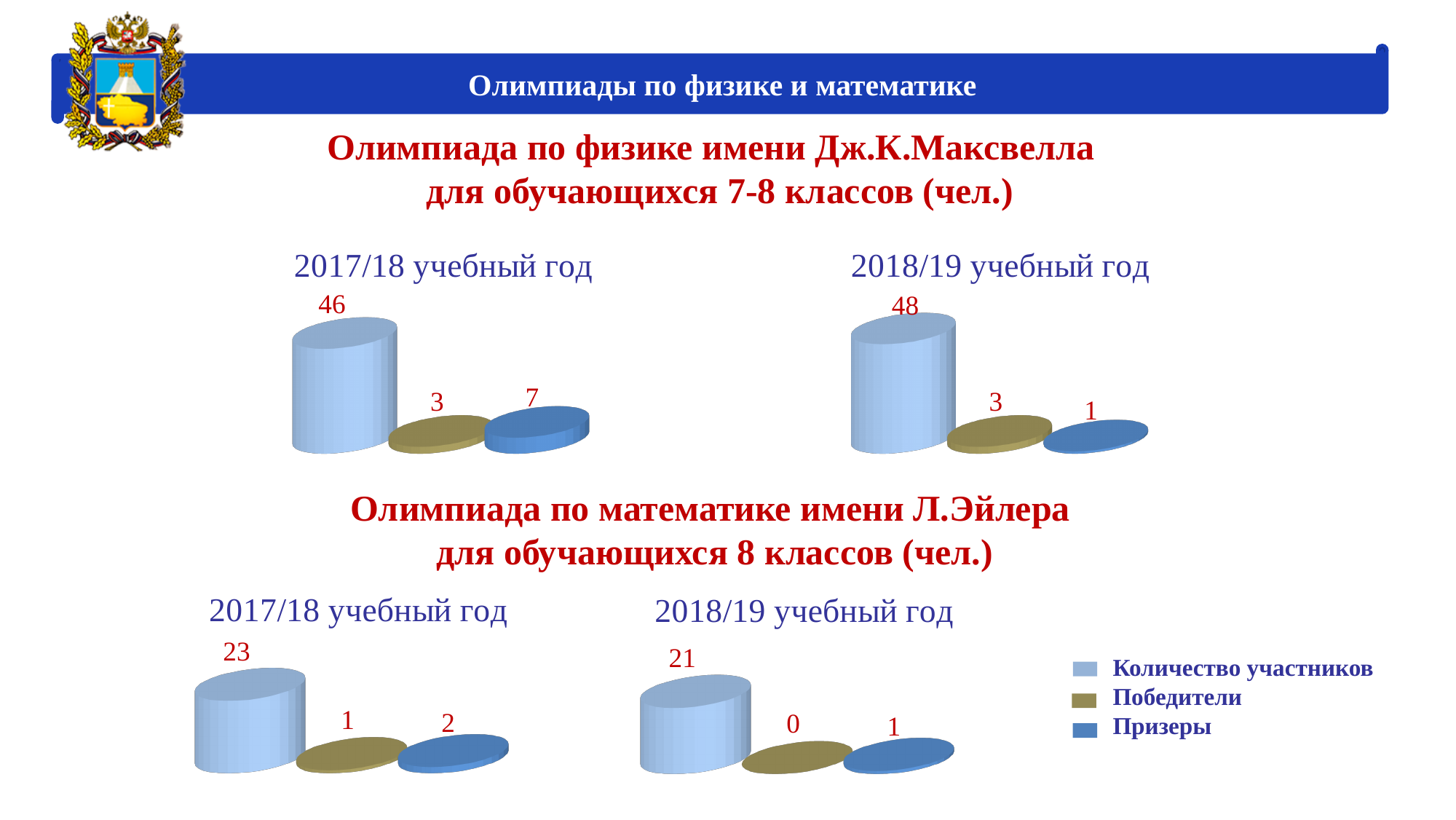
In the Euler mathematics olympiad chart for 2017/18 учебный год, what is the value for Победители? 1 How many series does the legend list? 3 In the Maxwell physics olympiad chart for 2017/18 учебный год, what is the value for Количество участников? 46 What is the difference between Количество участников in the Maxwell physics olympiad charts for 2018/19 and 2017/18? 2 In the Maxwell physics olympiad chart for 2017/18 учебный год, what is the difference between Призеры and Победители? 4 Which is larger: Призеры in the Maxwell physics olympiad chart for 2017/18 or Призеры in the chart for 2018/19? 2017/18 In the Maxwell physics olympiad chart for 2018/19 учебный год, what is the value for Призеры? 1 In the Euler mathematics olympiad chart for 2018/19 учебный год, what is the value for Количество участников? 21 In the Euler mathematics olympiad chart for 2018/19 учебный год, which series has the lowest value? Победители In the Maxwell physics olympiad chart for 2017/18 учебный год, which series has the highest value? Количество участников Which colour represents Победители in the legend? Olive (khaki) What kind of chart is used for the Euler mathematics olympiad 2017/18 учебный год data? Bar chart